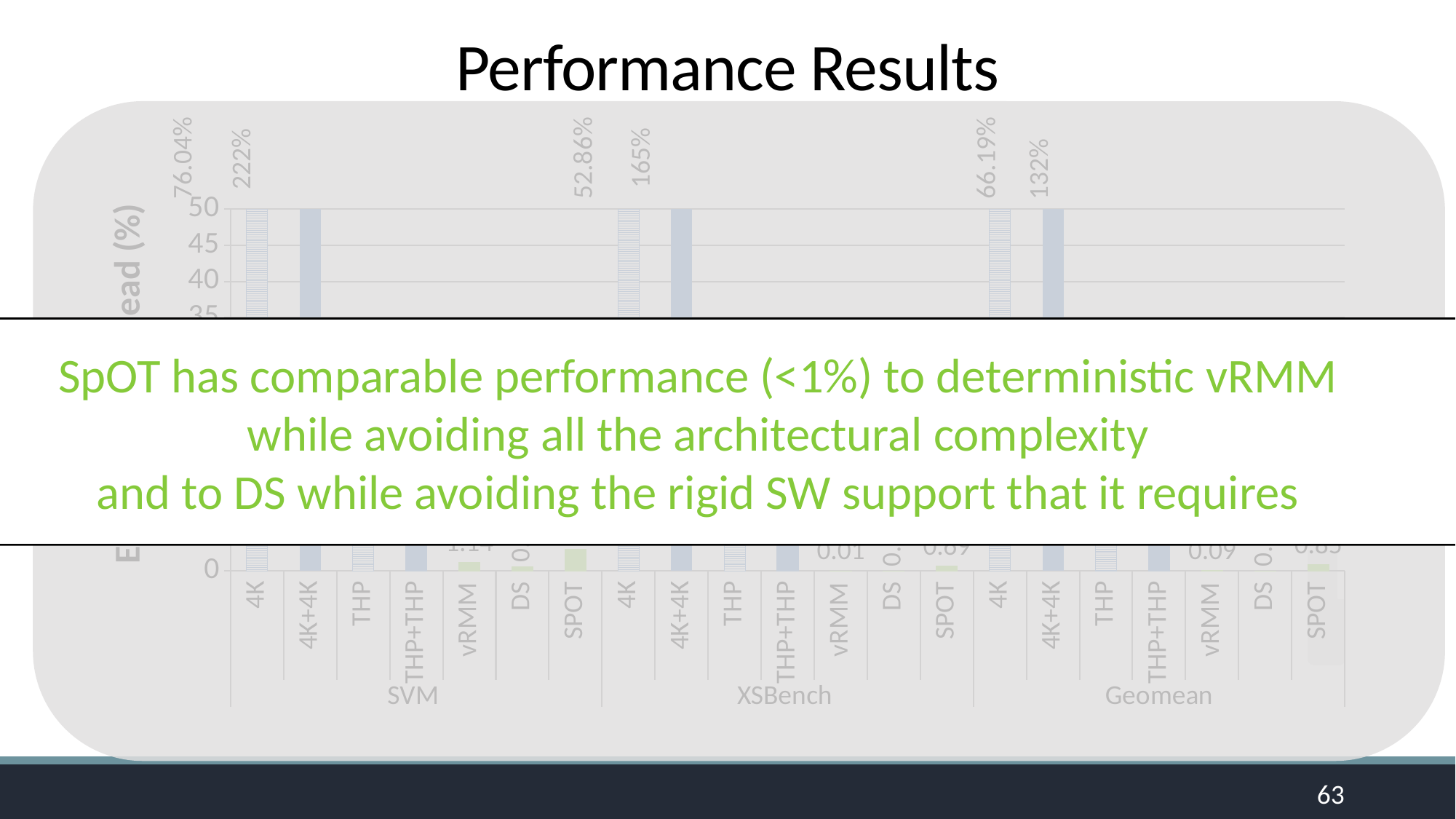
Which is larger, the 4K+4K value for SVM or the 4K+4K value for XSBench? SVM What is the value shown for 4K in the XSBench group? 52.86% Among the three groups, which has the highest 4K+4K value? SVM What is the value shown for 4K+4K in the Geomean group? 132% What is the value shown for 4K+4K in the SVM group? 222% How many benchmark groups are shown along the x axis? 3 What is the difference between the 4K+4K value for SVM and the 4K+4K value for Geomean? 90% What is the value shown for 4K in the Geomean group? 66.19% What is the value shown for 4K in the SVM group? 76.04% How many configurations are plotted within each group? 7 What kind of chart is shown on the slide? bar chart What is the value shown for 4K+4K in the XSBench group? 165%